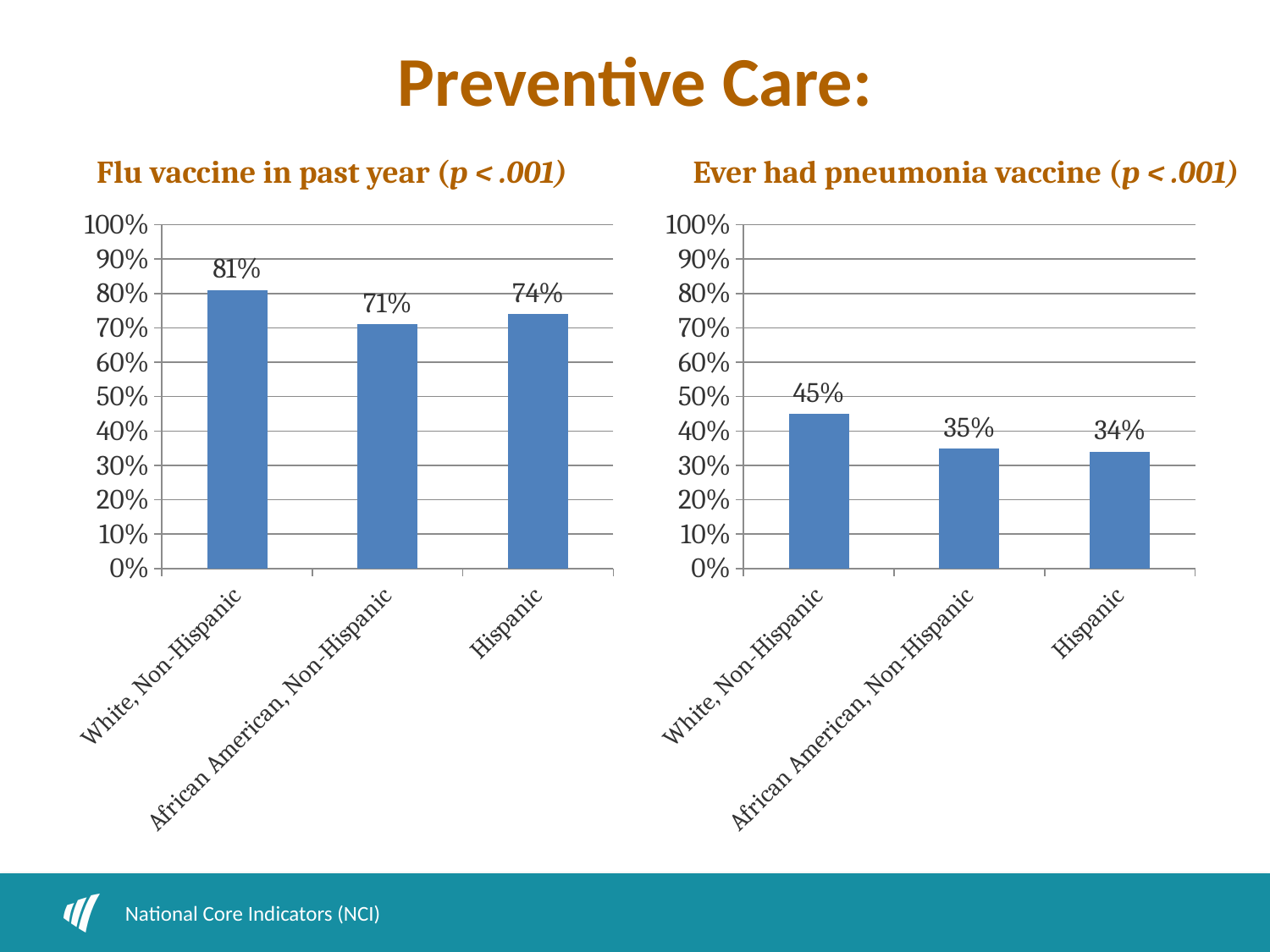
In the 'Flu vaccine in past year' chart, what is the difference between the values for White, Non-Hispanic and African American, Non-Hispanic? 10% In the 'Ever had pneumonia vaccine' chart, which category has the lowest value? Hispanic How many categories are shown in the 'Ever had pneumonia vaccine' chart? 3 In the 'Ever had pneumonia vaccine' chart, is the value for White, Non-Hispanic greater or less than 50%? less In the 'Ever had pneumonia vaccine' chart, what is the value for Hispanic? 34% In the 'Ever had pneumonia vaccine' chart, what is the value for White, Non-Hispanic? 45% In the 'Flu vaccine in past year' chart, which is larger: the value for Hispanic or the value for African American, Non-Hispanic? Hispanic In the 'Flu vaccine in past year' chart, which category has the highest value? White, Non-Hispanic In the 'Ever had pneumonia vaccine' chart, what is the difference between the values for White, Non-Hispanic and Hispanic? 11% In the 'Flu vaccine in past year' chart, what is the value for White, Non-Hispanic? 81% What kind of chart is the 'Flu vaccine in past year' chart? Bar chart In the 'Flu vaccine in past year' chart, what is the value for African American, Non-Hispanic? 71%